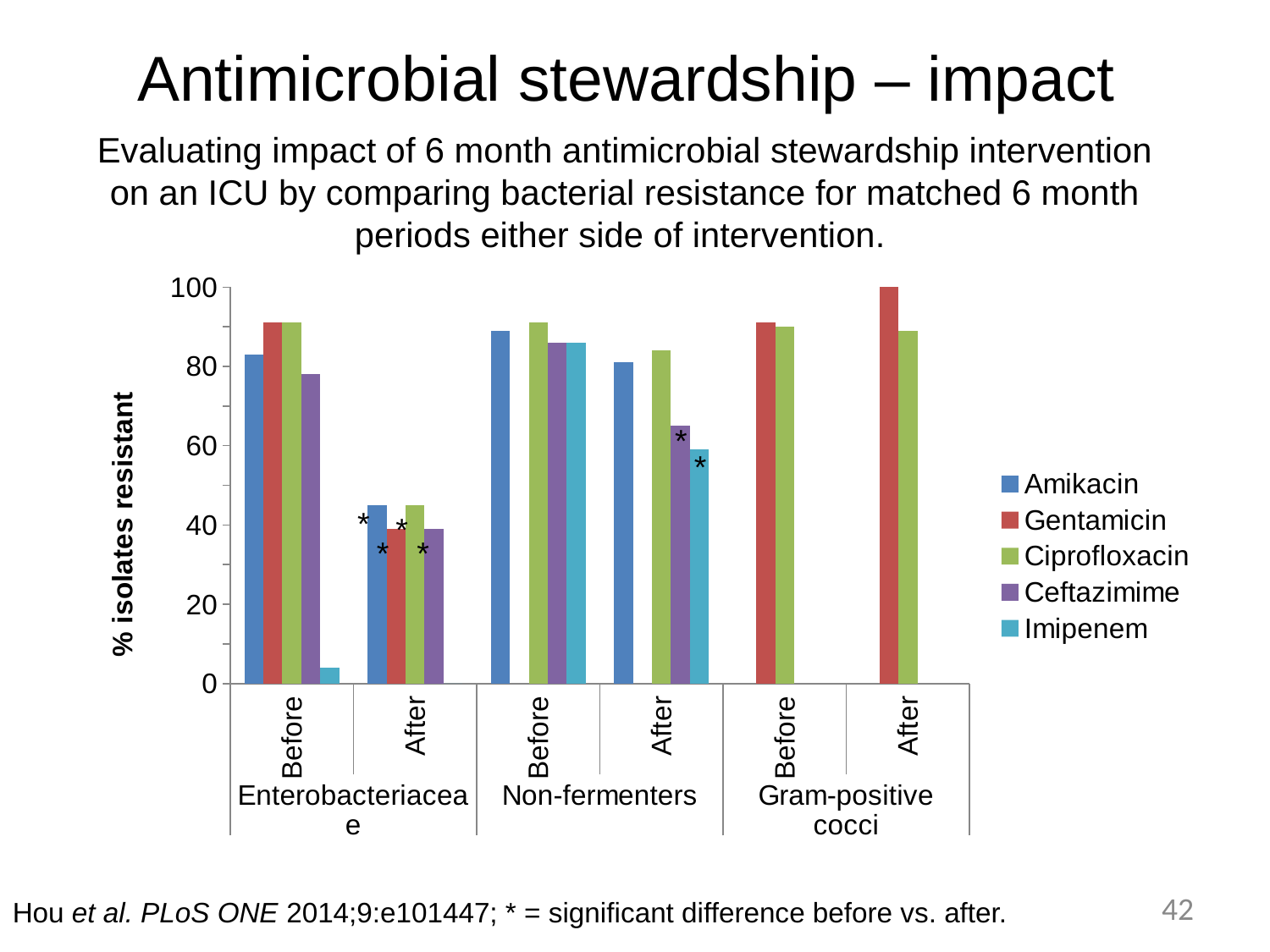
For Gentamicin in Gram-positive cocci, which is larger: Before or After? After How many bacterial groups are shown along the x axis? 3 Is the Ceftazimime value for Enterobacteriaceae After greater or less than 60? less Is the Imipenem value for Non-fermenters After greater or less than 40? greater Is the Imipenem value for Enterobacteriaceae Before greater or less than 20? less What kind of chart is shown on the slide? bar chart For Amikacin in Enterobacteriaceae, which is larger: Before or After? Before For Ceftazimime in Non-fermenters, which is larger: Before or After? Before Which colour represents Gentamicin in the legend? red What is the label on the vertical axis? % isolates resistant How many series does the legend list? 5